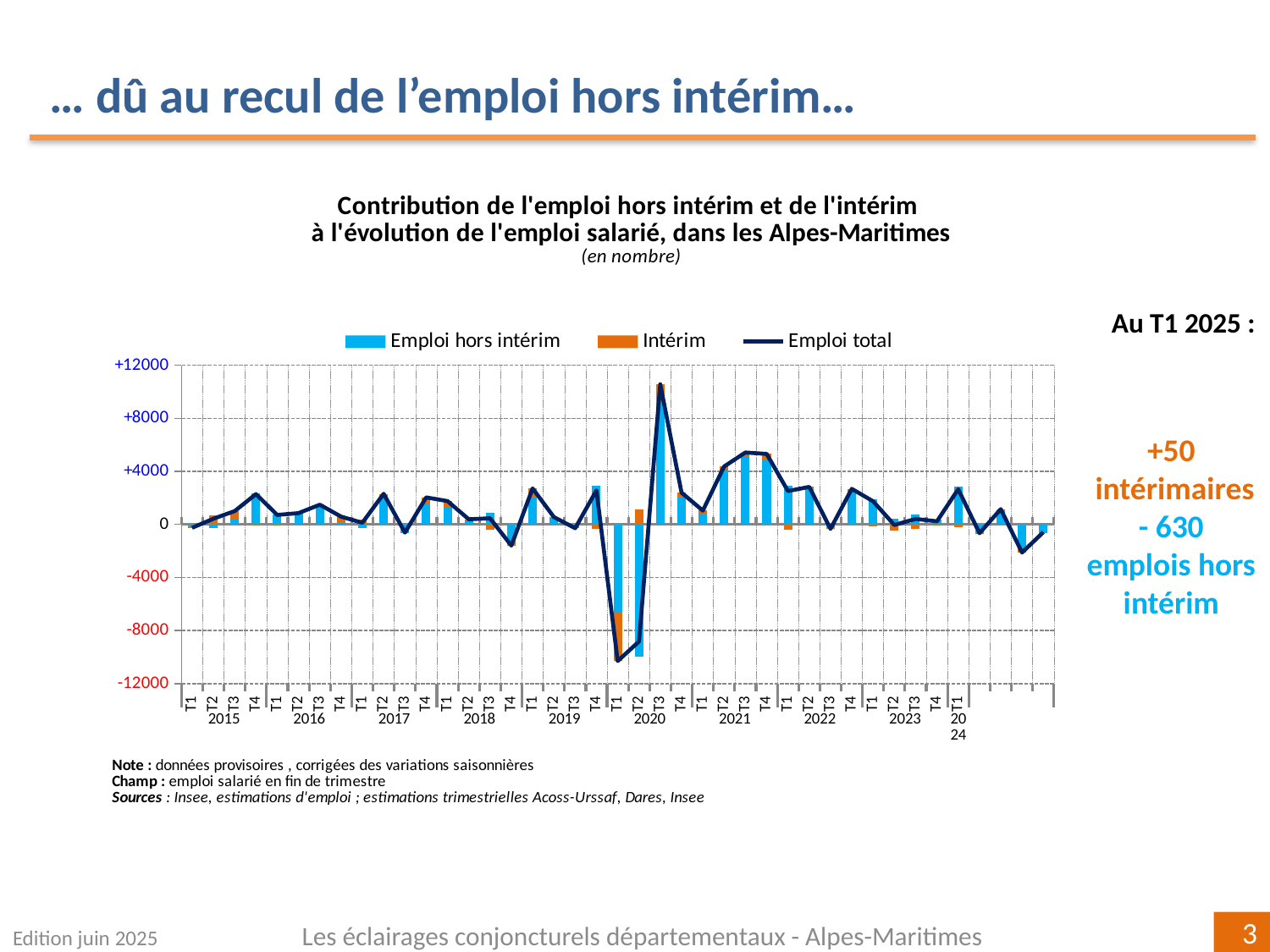
In which quarter does the Emploi total line reach its lowest value? T1 2020 How many series does the chart legend list? 3 Which is larger, the Emploi total value in T3 2020 or in T1 2021? T3 2020 Does the Emploi total line rise or fall between T3 2020 and T1 2021? Fall In which quarter does the Emploi total line reach its highest value? T3 2020 What kind of chart is shown on the slide? Combined bar and line chart Is the value of Emploi total in T1 2020 greater or less than -8000? less According to the text beside the chart, what is the change in emplois hors intérim at T1 2025? -630 According to the text beside the chart, what is the change in intérimaires at T1 2025? +50 Is the value of Emploi total in T3 2021 greater or less than 4000? greater Which series in the legend is drawn as a line rather than bars? Emploi total Is the value of Emploi total in T3 2020 greater or less than 8000? greater